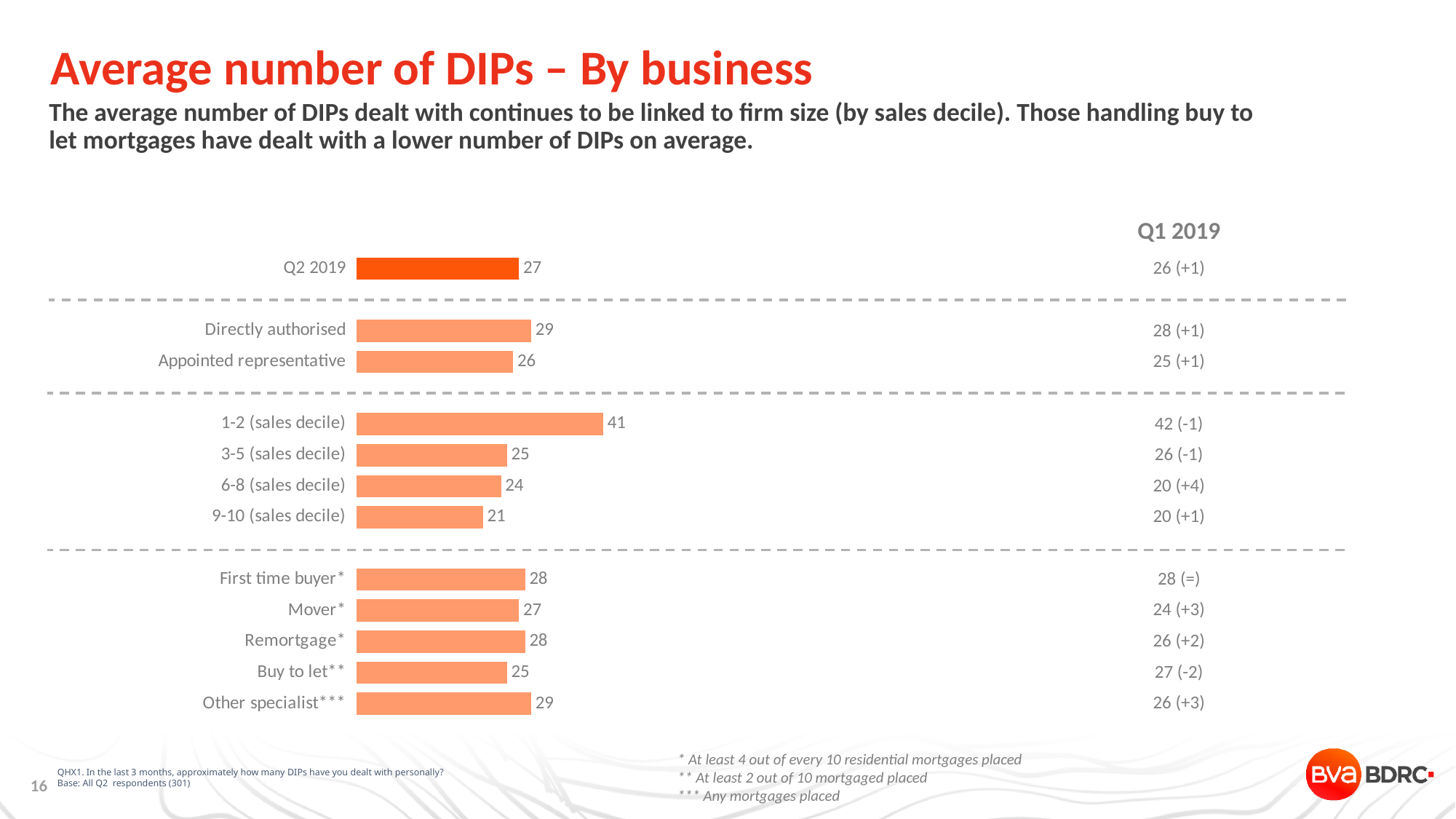
How many categories are plotted in the chart? 12 What kind of chart is shown? Bar chart Which category has the highest value? 1-2 (sales decile) Which category has the lowest value? 9-10 (sales decile) What is the difference between 1-2 (sales decile) and 9-10 (sales decile)? 20 What is the title of the slide? Average number of DIPs – By business What is the difference between Directly authorised and Appointed representative? 3 Which is larger, Mover or Remortgage? Remortgage What was the Q1 2019 value for 6-8 (sales decile)? 20 (+4) What is the value for Q2 2019 overall? 27 What is the value for 1-2 (sales decile)? 41 What is the value for Buy to let? 25